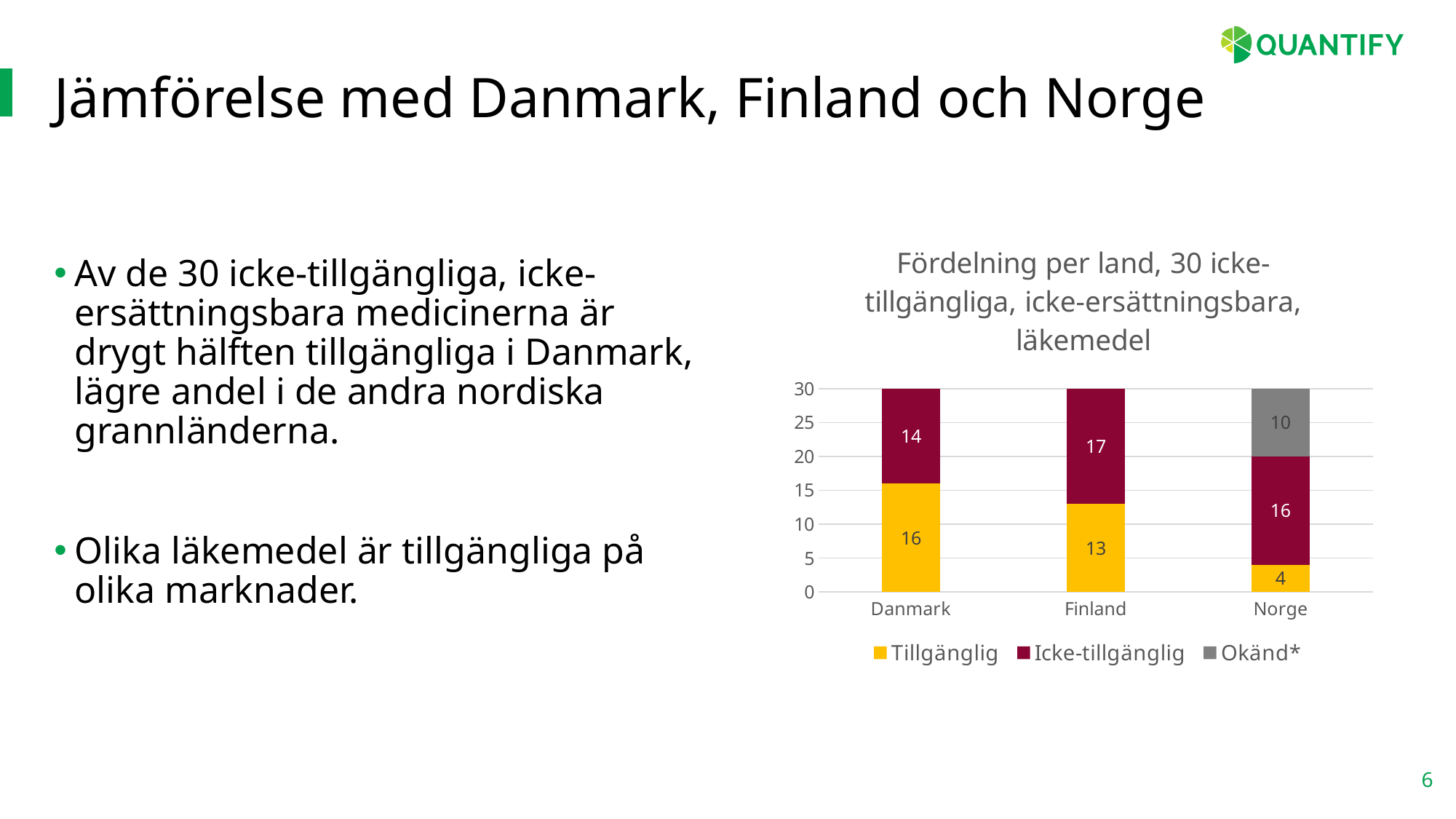
What is the difference between the Tillgänglig values for Danmark and Finland? 3 What is the Okänd* value for Norge? 10 Which country has the lowest Tillgänglig value? Norge What is the Tillgänglig value for Norge? 4 Which is larger, the Icke-tillgänglig value for Finland or for Norge? Finland Which country has the highest Tillgänglig value? Danmark What is the total of the stacked bar for Norge? 30 What is the Icke-tillgänglig value for Finland? 17 How many countries are shown on the x axis? 3 How many series does the legend list? 3 What kind of chart is shown on the slide? Stacked bar chart What is the Tillgänglig value for Danmark? 16